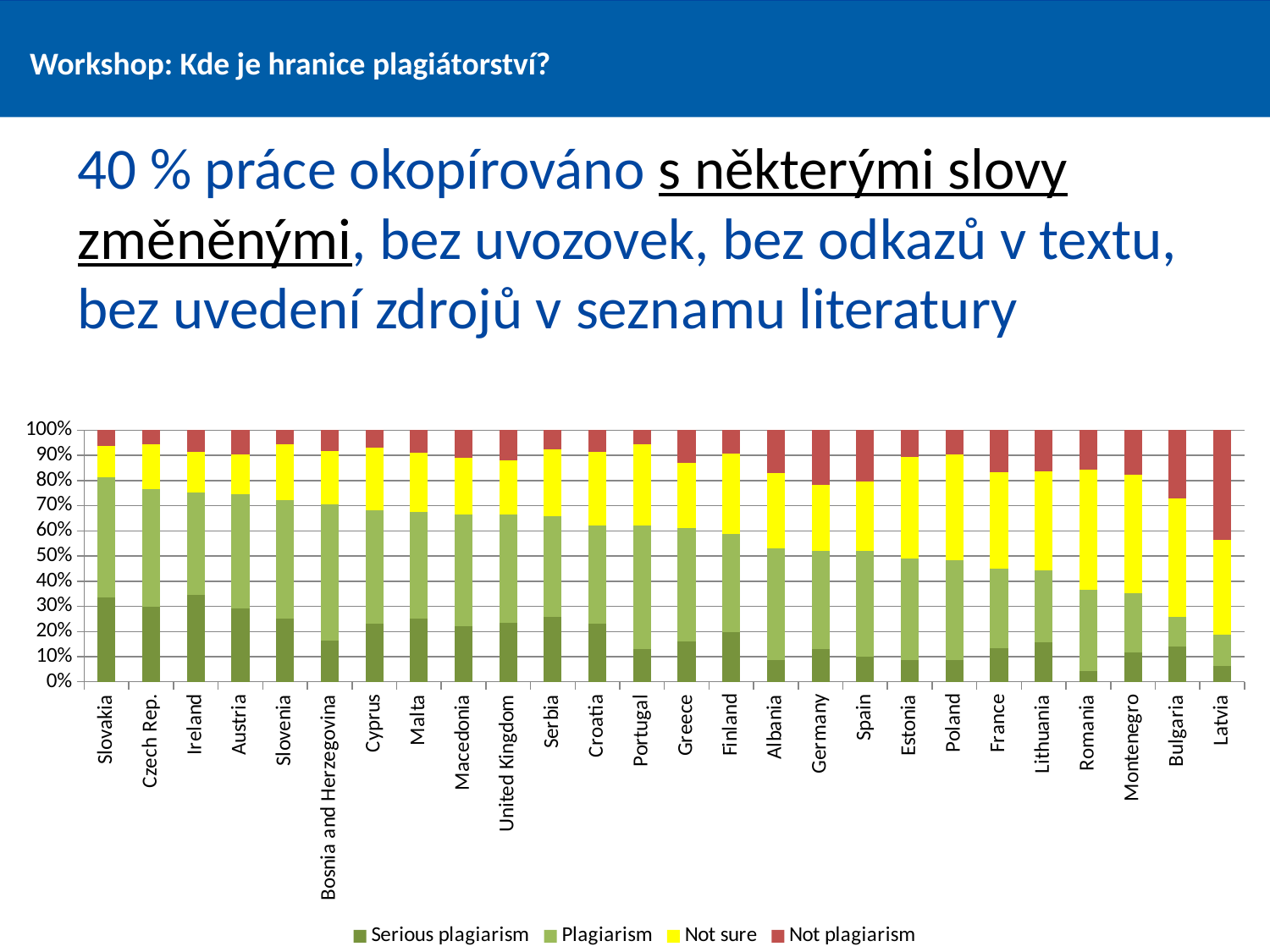
How many series does the chart legend list? 4 Which country has the largest 'Not plagiarism' share in the chart? Latvia Is the 'Not plagiarism' value for Latvia greater or less than 30%? greater Is the 'Not plagiarism' value for Slovakia greater or less than 10%? less Which is larger: the 'Serious plagiarism' share for Ireland or for Romania? Ireland How many countries are shown on the x axis of the chart? 26 What kind of chart is shown on the slide? stacked bar chart Is the 'Serious plagiarism' value for Latvia greater or less than 10%? less Which country has the smallest 'Serious plagiarism' share in the chart? Romania Moving from left to right along the x axis, does the combined share of 'Serious plagiarism' and 'Plagiarism' generally rise or fall? fall What are the four series listed in the chart legend? Serious plagiarism, Plagiarism, Not sure, Not plagiarism Which colour represents the 'Not sure' series in the chart? yellow